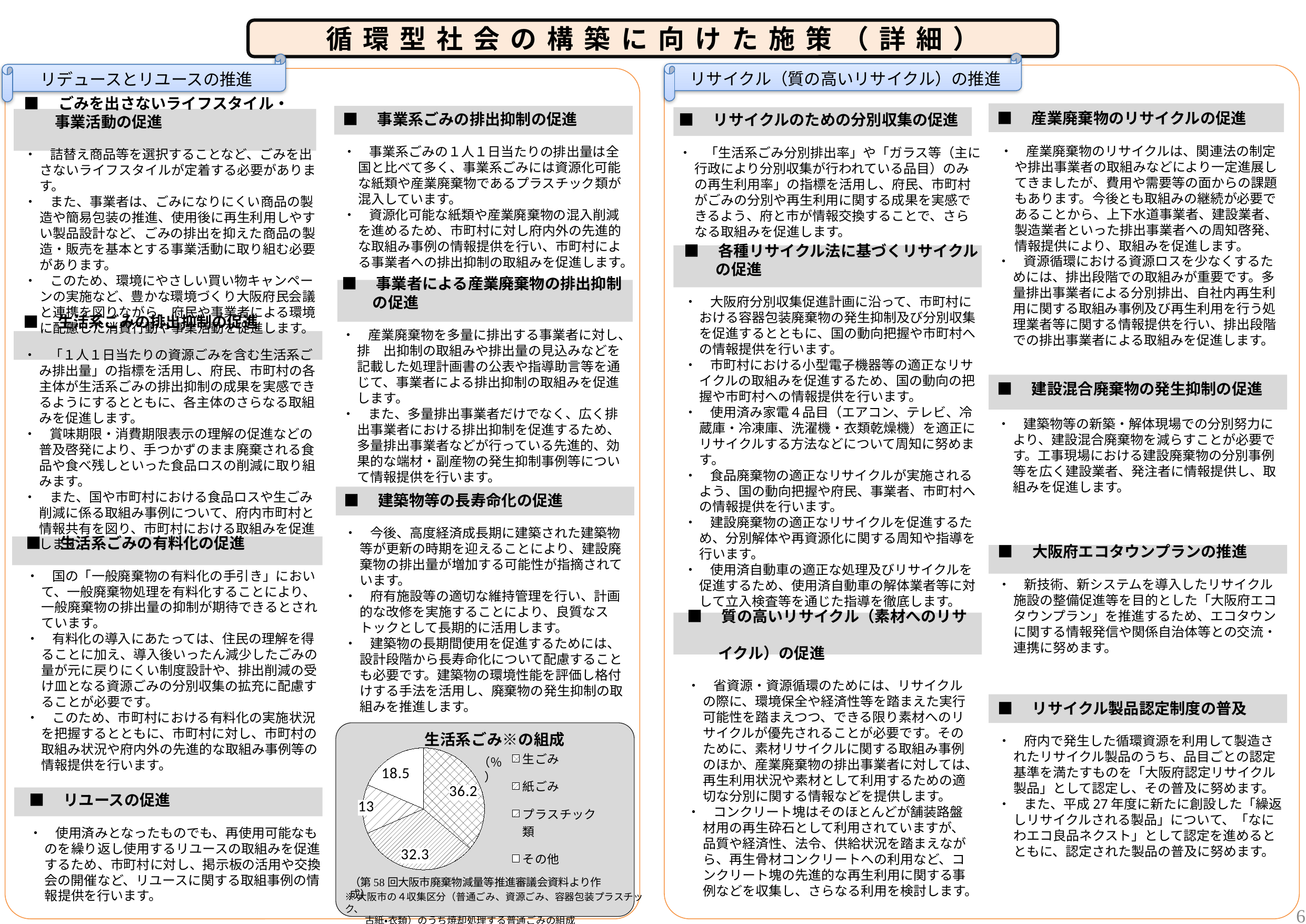
What is the value shown for 生ごみ in the pie chart? 36.2 What is the value shown for プラスチック類 in the pie chart? 13 What is the value shown for その他 in the pie chart? 18.5 What unit is indicated for the values in the pie chart? % How many categories does the legend of the pie chart list? 4 What is the difference between the values for 生ごみ and 紙ごみ? 3.9 What is the value shown for 紙ごみ in the pie chart? 32.3 What kind of chart is shown on the slide? pie chart Which is larger, the value for その他 or the value for プラスチック類? その他 Which category has the largest slice in the pie chart? 生ごみ What is the title of the chart? 生活系ごみ※の組成 Which category has the smallest slice in the pie chart? プラスチック類